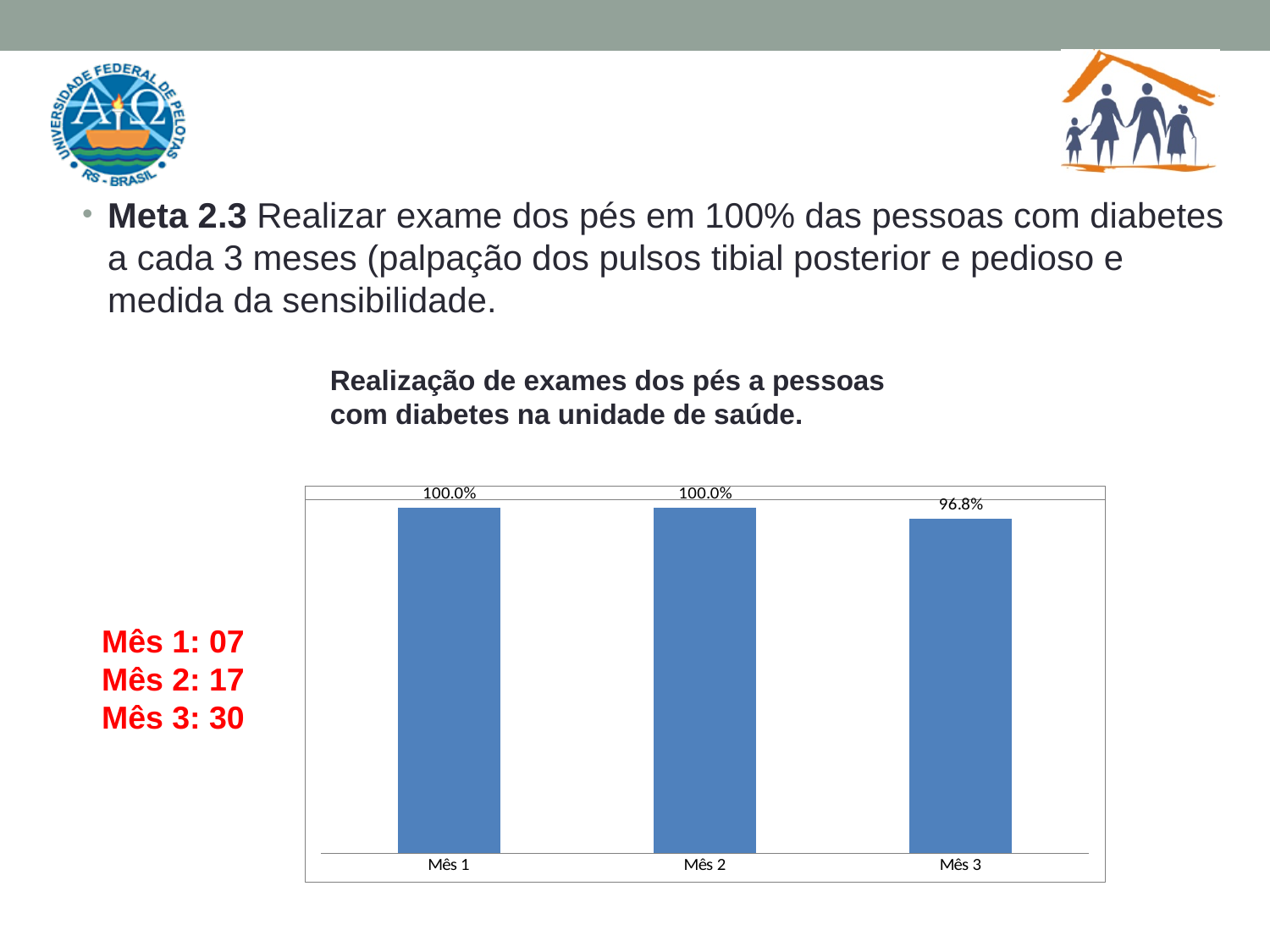
Which month has the lowest value? Mês 3 Do the values for Mês 1 and Mês 2 differ? No, both are 100.0% What is the value for Mês 3? 96.8% What is the title of the chart? Realização de exames dos pés a pessoas com diabetes na unidade de saúde. What kind of chart is shown on the slide? Bar chart Do the values rise, fall or stay the same from Mês 1 to Mês 3? Fall What colour are the bars in the chart? Blue How many categories are shown on the x axis? 3 What is the difference between the values for Mês 1 and Mês 3? 3.2% What is the value for Mês 2? 100.0% Which is larger, the value for Mês 2 or the value for Mês 3? Mês 2 What is the value for Mês 1? 100.0%